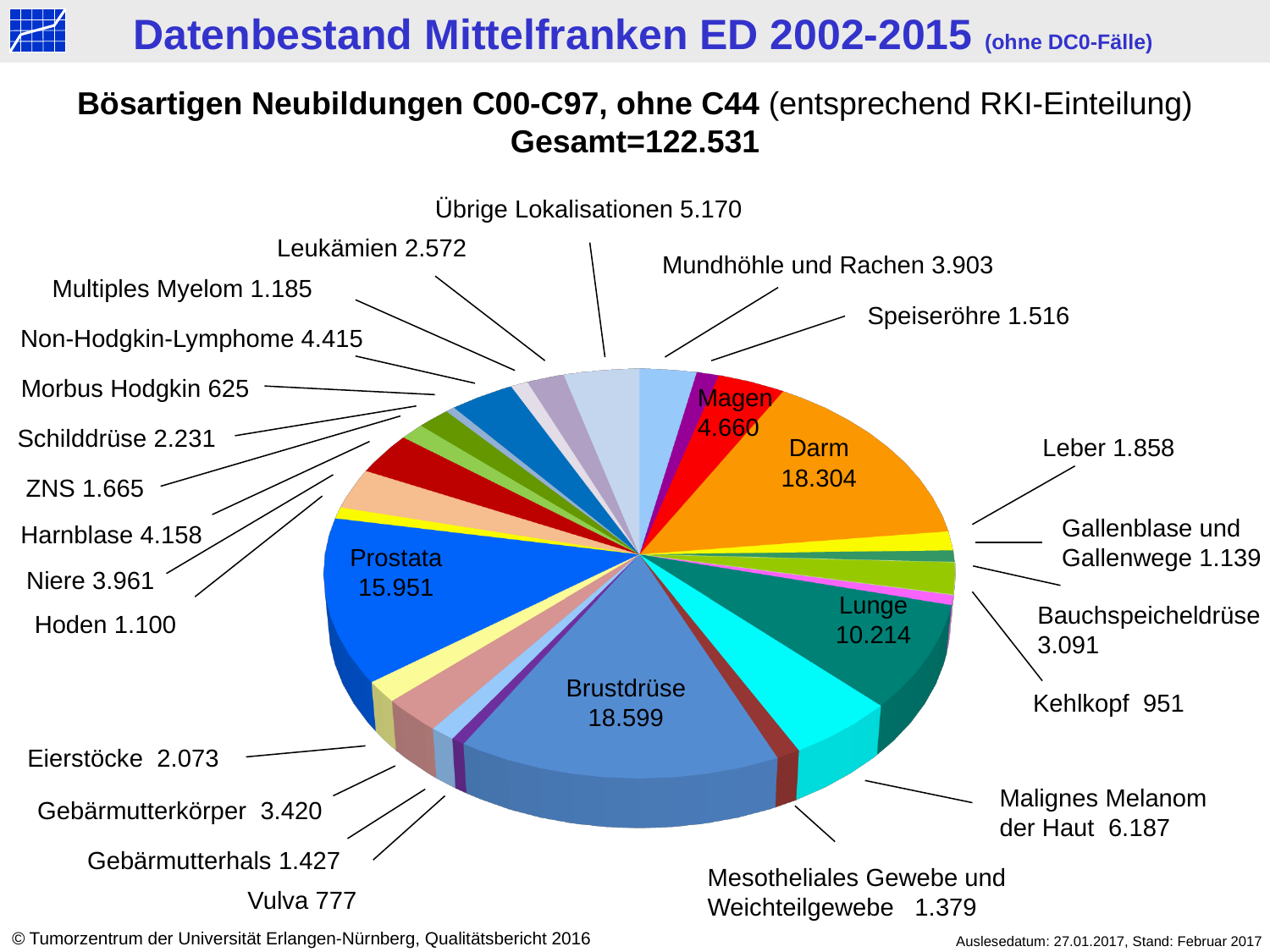
What is the value shown for Lunge? 10.214 Which category has the smallest value in the pie chart? Morbus Hodgkin What is the difference between the values for Brustdrüse and Darm? 295 Which is larger, the value for Prostata or the value for Lunge? Prostata What is the value shown for Malignes Melanom der Haut? 6.187 Which category has the largest value in the pie chart? Brustdrüse What total (Gesamt) is stated above the pie chart? 122.531 What is the value shown for Gebärmutterkörper? 3.420 What is the difference between the values for Darm and Prostata? 2.353 How many categories (slices) are labelled in the pie chart? 27 What kind of chart is shown on the slide? pie chart What is the value shown for Darm? 18.304